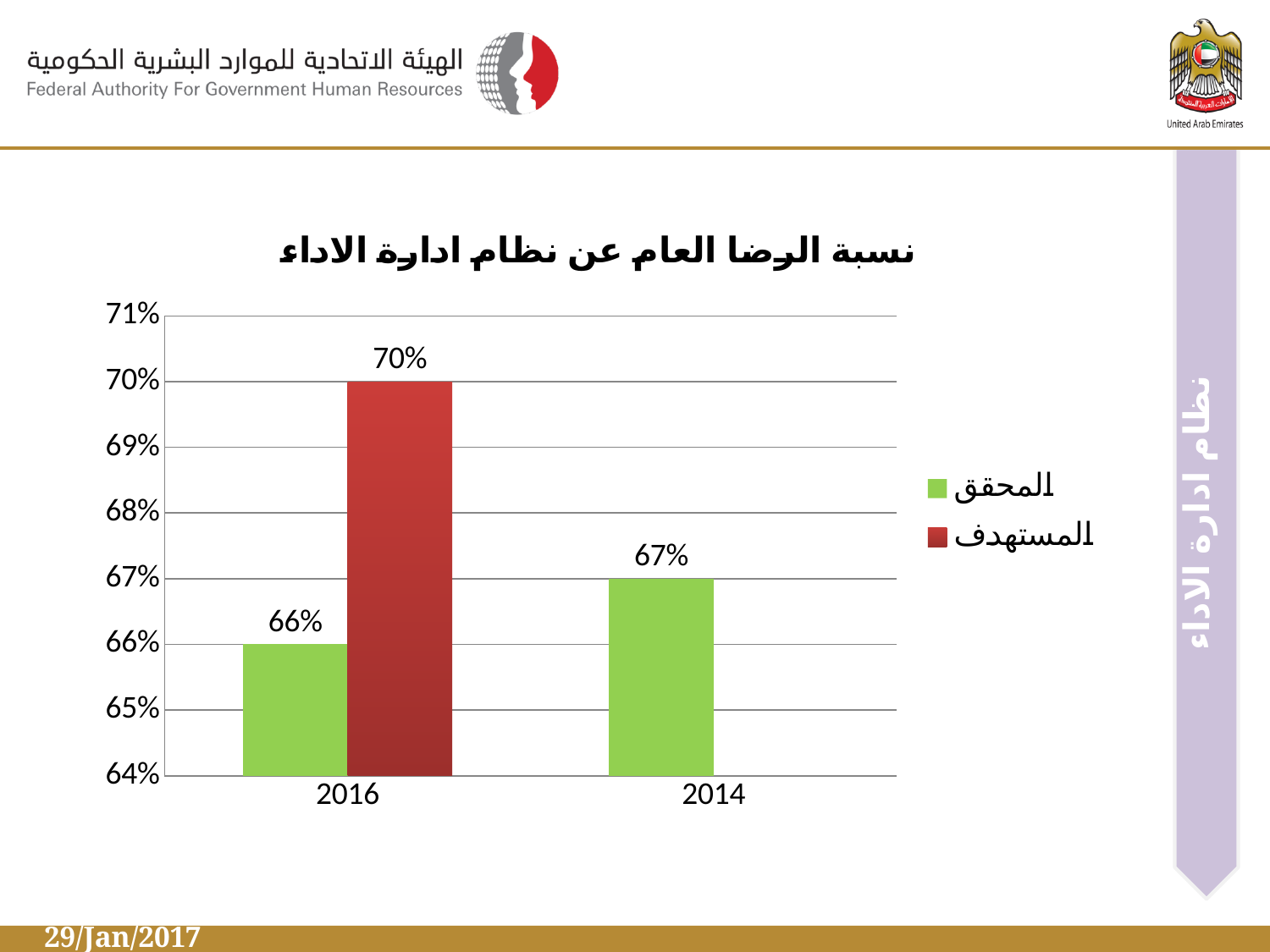
What is the value of المحقق (achieved) for 2016? 66% Which bar has the lowest value in the chart? المحقق for 2016 (66%) Which colour represents المستهدف (target) in the legend? Red What is the difference between the target (المستهدف) and the achieved (المحقق) values for 2016? 4% What is the value of المستهدف (target) for 2016? 70% Which is larger: the achieved (المحقق) value for 2014 or for 2016? 2014 What is the value of المحقق (achieved) for 2014? 67% How many year categories are shown on the x axis? 2 Which bar has the highest value in the chart? المستهدف for 2016 (70%) What kind of chart is shown on the slide? Bar chart What is the difference between the achieved (المحقق) values for 2014 and 2016? 1% How many series does the legend list? 2